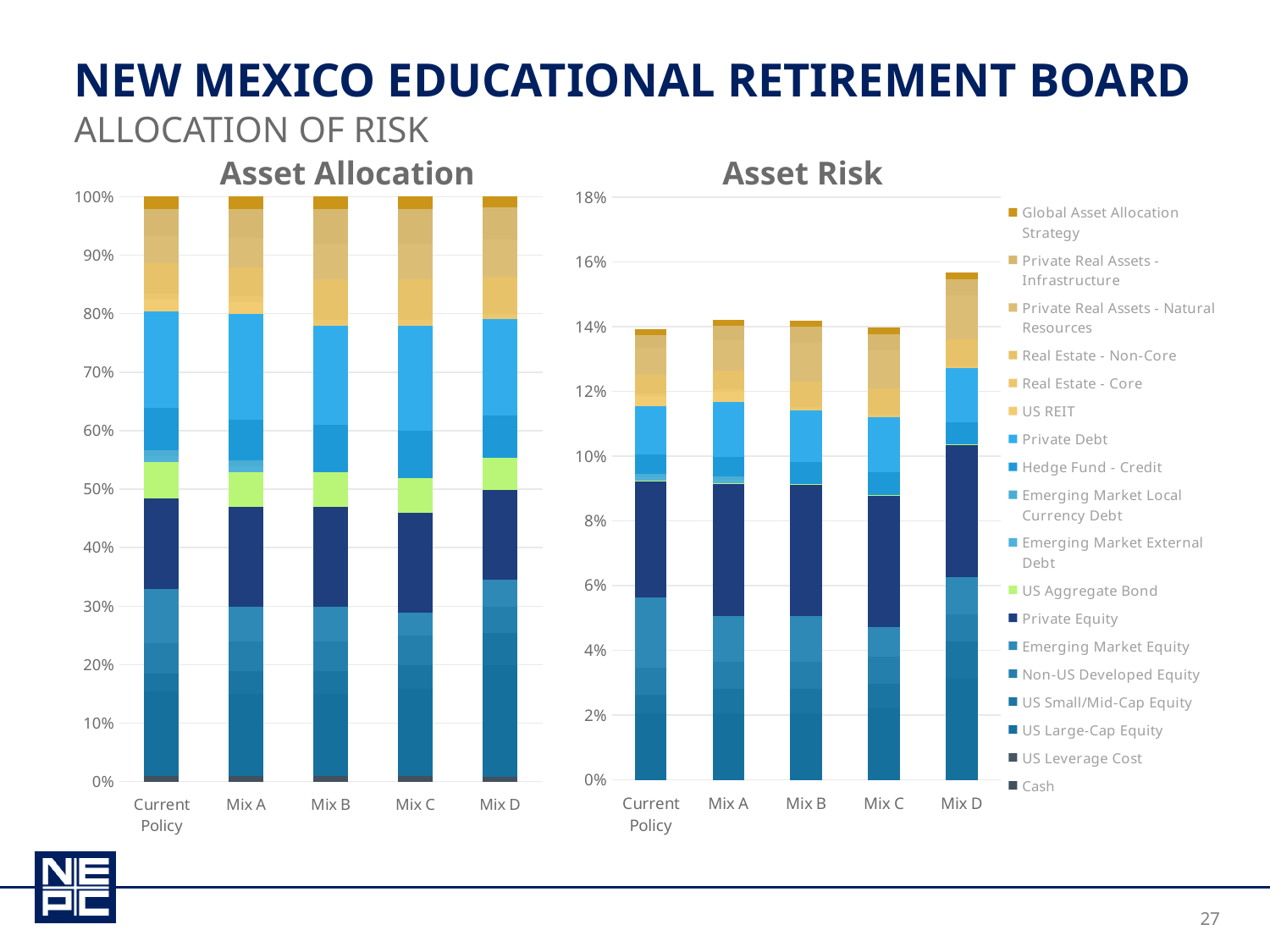
In the Asset Risk chart, is the total for Mix D greater or less than 15%? greater How many categories are shown on the x axis of the Asset Risk chart? 5 In the Asset Allocation chart, what is the total of the Current Policy stacked bar? 100% In the Asset Risk chart, is the total for Mix C greater or less than 16%? less What is the title of the chart on the right side of the slide? Asset Risk In the Asset Risk chart, which category has the highest total bar? Mix D What is the highest value shown on the y axis of the Asset Risk chart? 18% What kind of chart is the Asset Allocation chart? stacked bar chart How many series does the legend list? 18 In the Asset Risk chart, which total bar is larger, Mix D or Current Policy? Mix D In the Asset Risk chart, is the total for Current Policy greater or less than 12%? greater